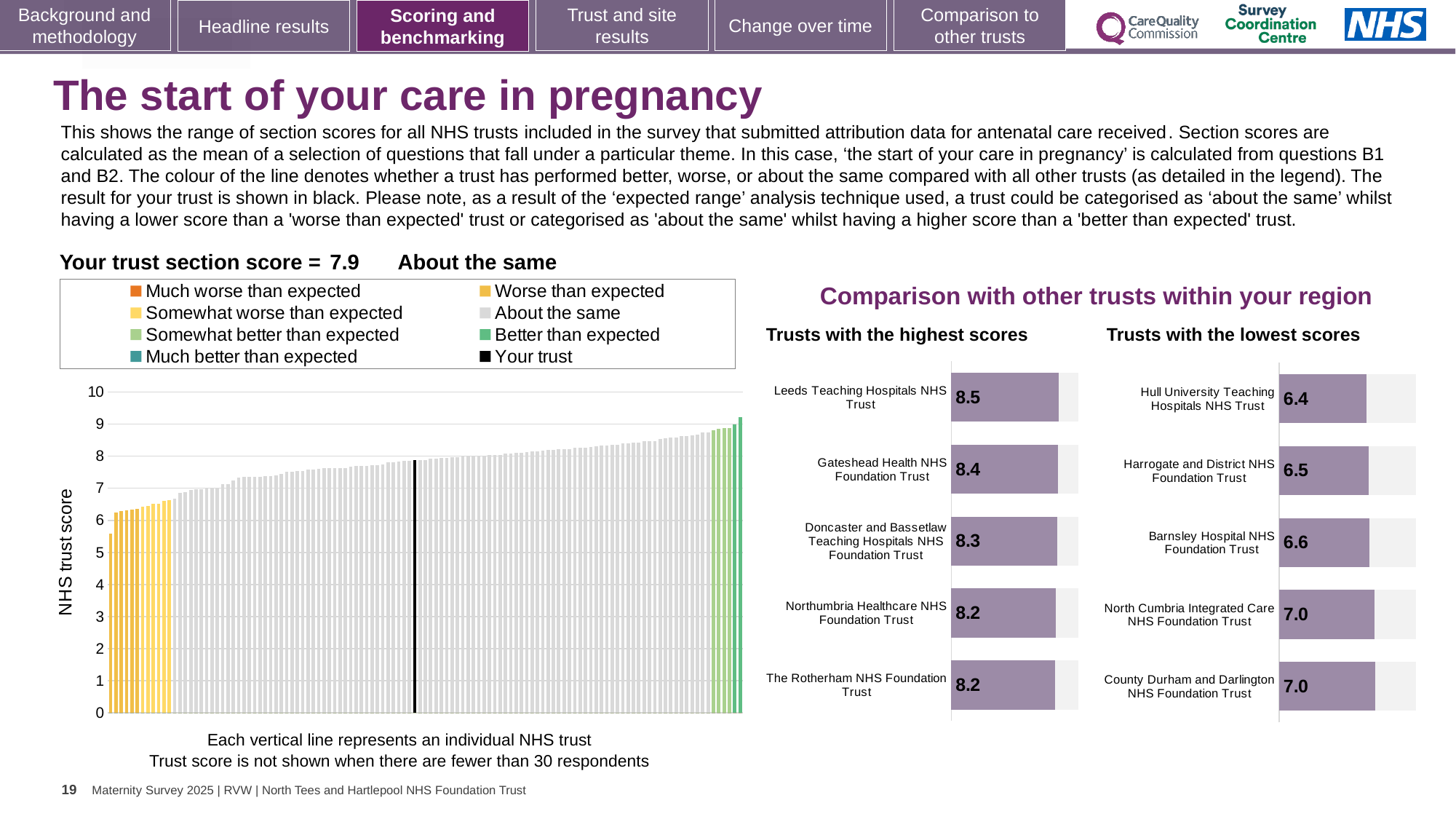
How many trusts are shown in the 'Trusts with the highest scores' chart? 5 In the large chart on the left, do the trust scores rise or fall from left to right? Rise In the 'Trusts with the lowest scores' chart, what is the score for Hull University Teaching Hospitals NHS Trust? 6.4 In the 'Trusts with the highest scores' chart, what is the difference between the scores of Leeds Teaching Hospitals NHS Trust and Gateshead Health NHS Foundation Trust? 0.1 In the 'Trusts with the lowest scores' chart, which trust has the lowest score? Hull University Teaching Hospitals NHS Trust In the 'Trusts with the lowest scores' chart, how much higher is Barnsley Hospital NHS Foundation Trust's score than Hull University Teaching Hospitals NHS Trust's score? 0.2 What kind of chart is the large chart on the left showing all NHS trusts? Bar chart In the 'Trusts with the highest scores' chart, what is the score for Leeds Teaching Hospitals NHS Trust? 8.5 What is the label on the vertical axis of the large chart on the left? NHS trust score In the 'Trusts with the highest scores' chart, which has the larger score: Doncaster and Bassetlaw Teaching Hospitals NHS Foundation Trust or Northumbria Healthcare NHS Foundation Trust? Doncaster and Bassetlaw Teaching Hospitals NHS Foundation Trust In the 'Trusts with the highest scores' chart, which trust has the highest score? Leeds Teaching Hospitals NHS Trust In the large chart on the left, is the value for the black bar (your trust) greater or less than 7? greater